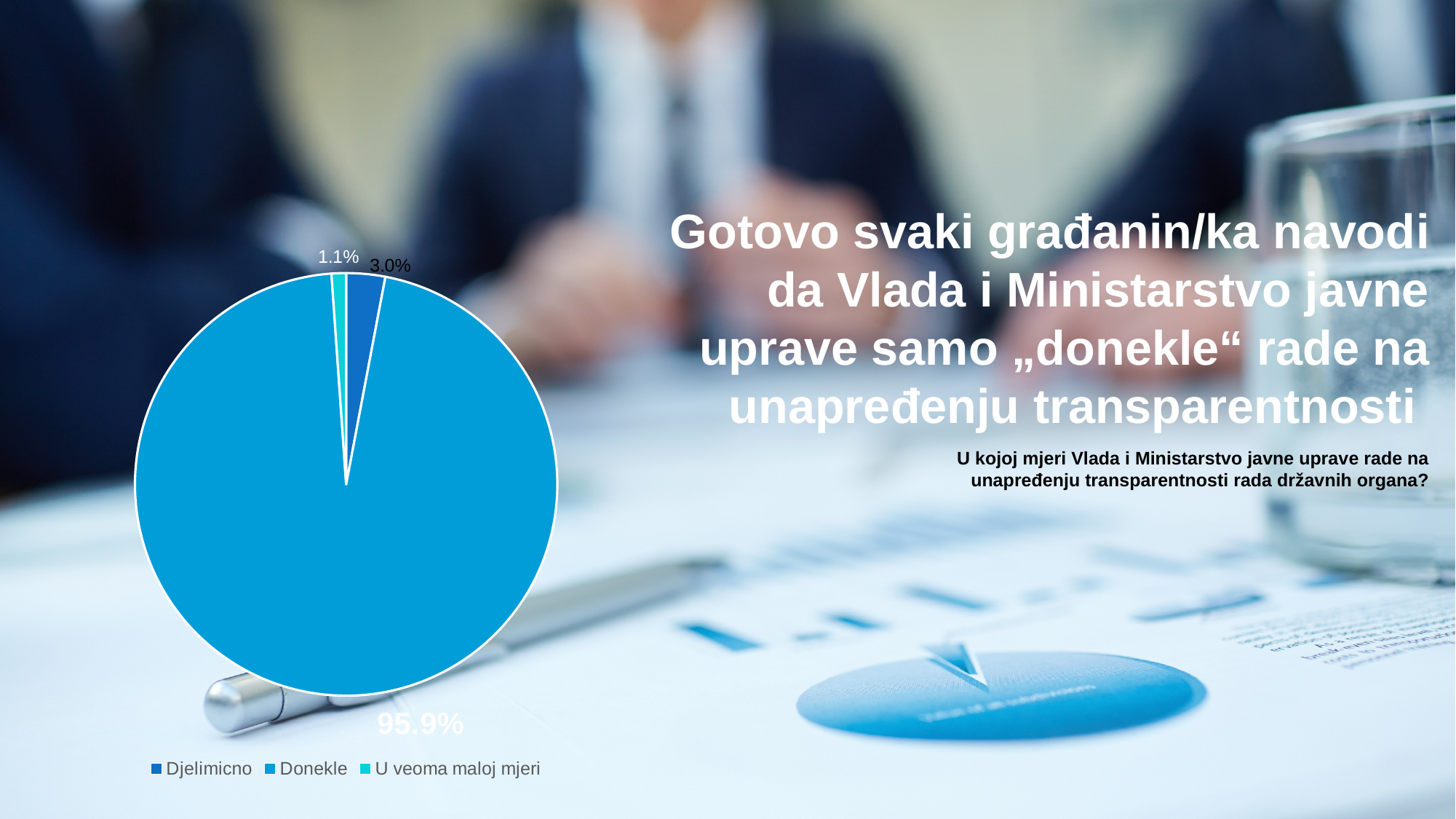
How many entries does the legend of the pie chart list? 3 What is the value shown for "U veoma maloj mjeri"? 1.1% Which is larger, the slice for "Djelimicno" or the slice for "U veoma maloj mjeri"? Djelimicno What is the difference between the "Djelimicno" share and the "U veoma maloj mjeri" share? 1.9% What kind of chart is shown on the slide? pie chart Which category has the largest slice of the pie? Donekle Which legend entry is shown in the darkest blue colour? Djelimicno What share of the pie does "Donekle" take? 95.9% What is the difference between the "Donekle" share and the "Djelimicno" share? 92.9% What is the value shown for "Djelimicno"? 3.0% Which category has the smallest slice of the pie? U veoma maloj mjeri How many categories does the pie chart show? 3